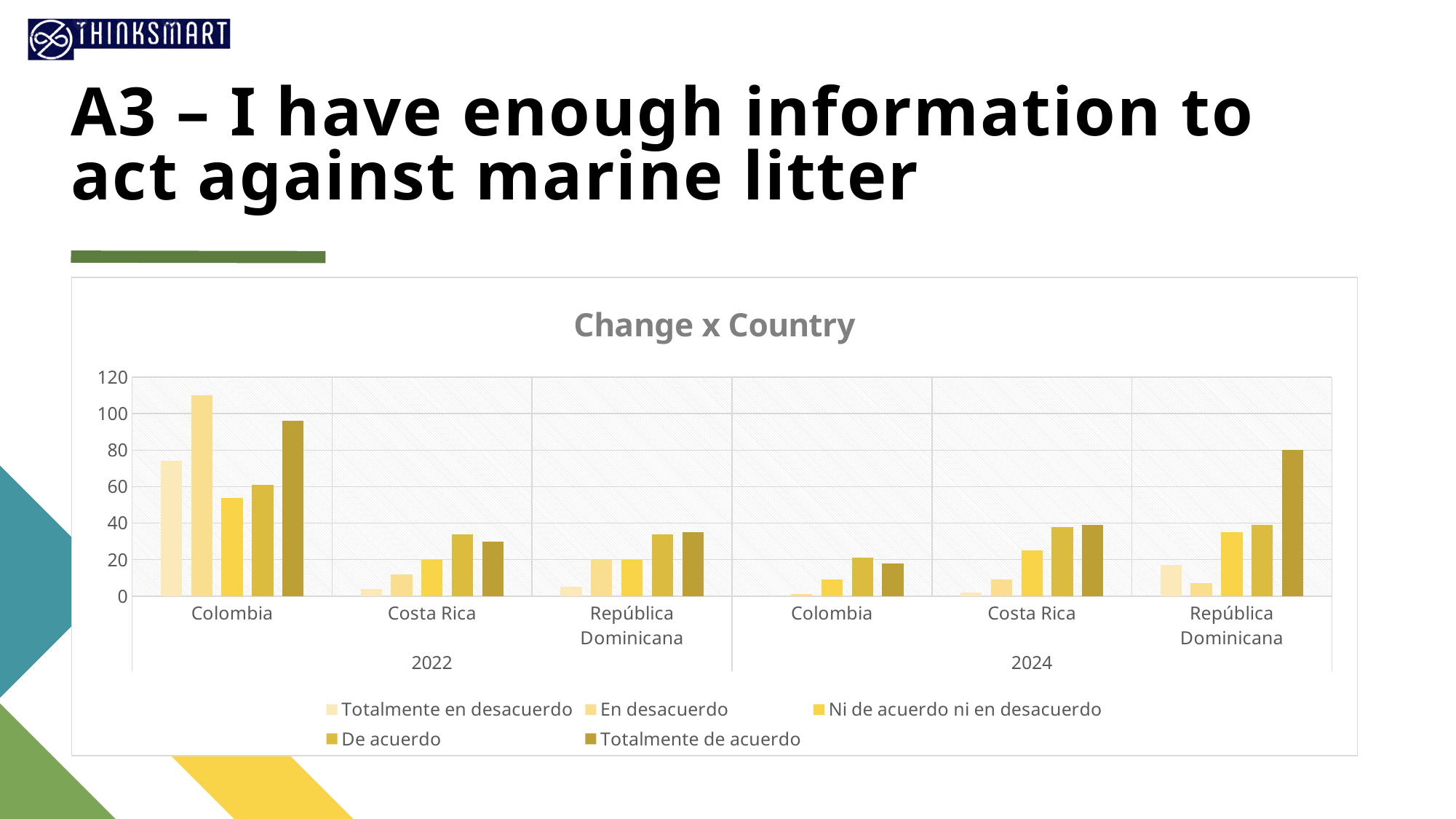
Is the value for 'Totalmente de acuerdo' for Colombia in 2022 greater or less than 80? greater For Costa Rica in 2022, which series has the lowest bar? Totalmente en desacuerdo Is the value for 'De acuerdo' for Costa Rica in 2022 greater or less than 40? less What kind of chart is shown on the slide? Bar chart What is the title of the chart? Change x Country Which two year groups are shown along the x axis? 2022 and 2024 Is the value for 'Totalmente de acuerdo' for República Dominicana in 2024 greater or less than 60? greater How many series does the legend list? 5 For República Dominicana in 2024, which series has the highest bar? Totalmente de acuerdo For Colombia in 2022, which series has the highest bar? En desacuerdo Which is larger: 'Totalmente en desacuerdo' for Colombia in 2022 or 'Totalmente en desacuerdo' for Colombia in 2024? Colombia in 2022